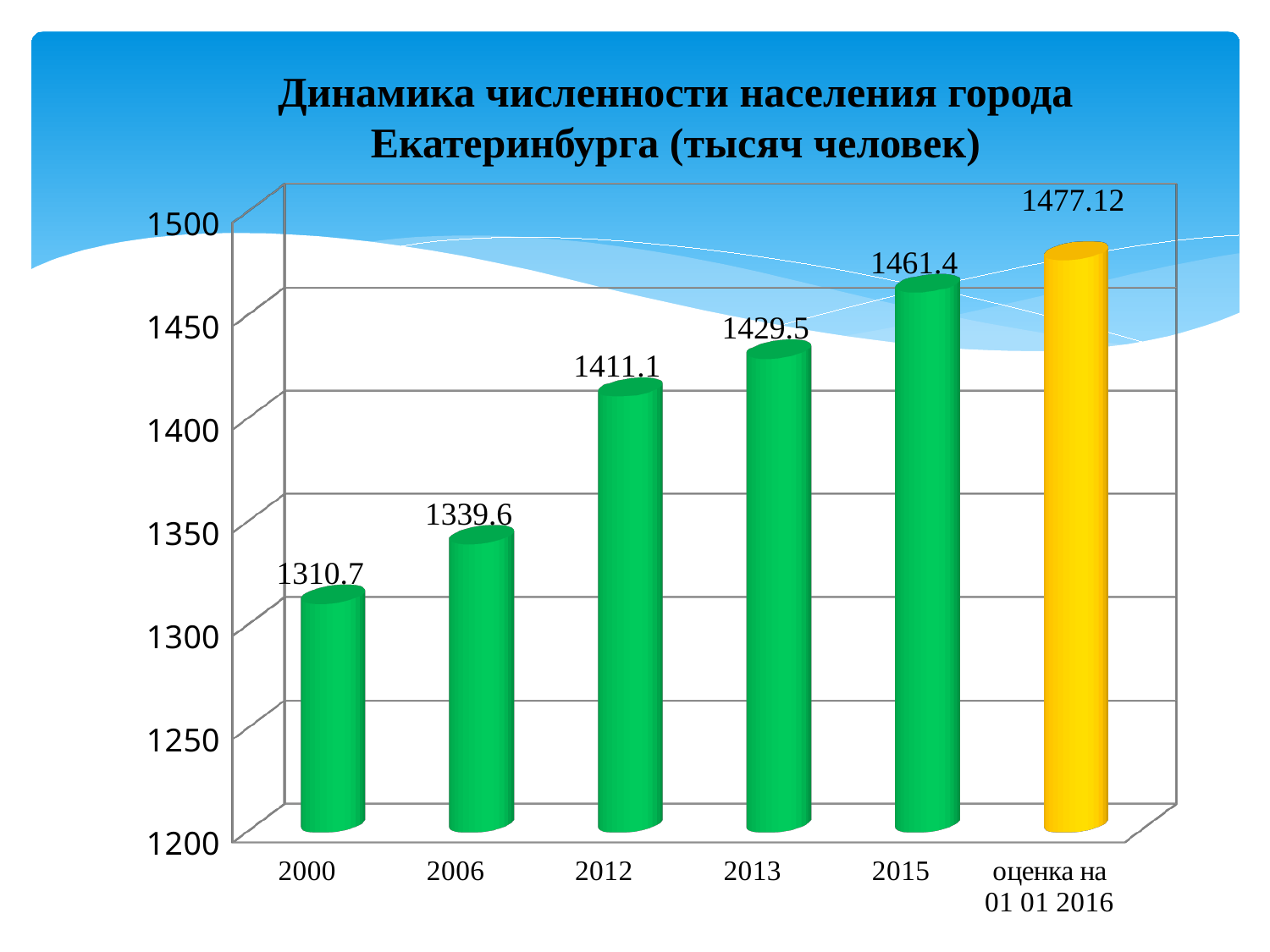
What kind of chart is shown on the slide? bar chart What is the population value shown for 2000? 1310.7 Is the value for 2013 greater or less than 1400? greater What is the difference between the values for 2015 and 2013? 31.9 What is the difference between the values for 2006 and 2000? 28.9 Do the values rise or fall from left to right along the x axis? rise What is the population value shown for 2012? 1411.1 How many bars are shown in the chart? 6 Which year has the lowest population value? 2000 Which category has the highest value? оценка на 01 01 2016 Which is larger, the value for 2012 or the value for 2006? 2012 What value is shown for the bar labelled 'оценка на 01 01 2016'? 1477.12